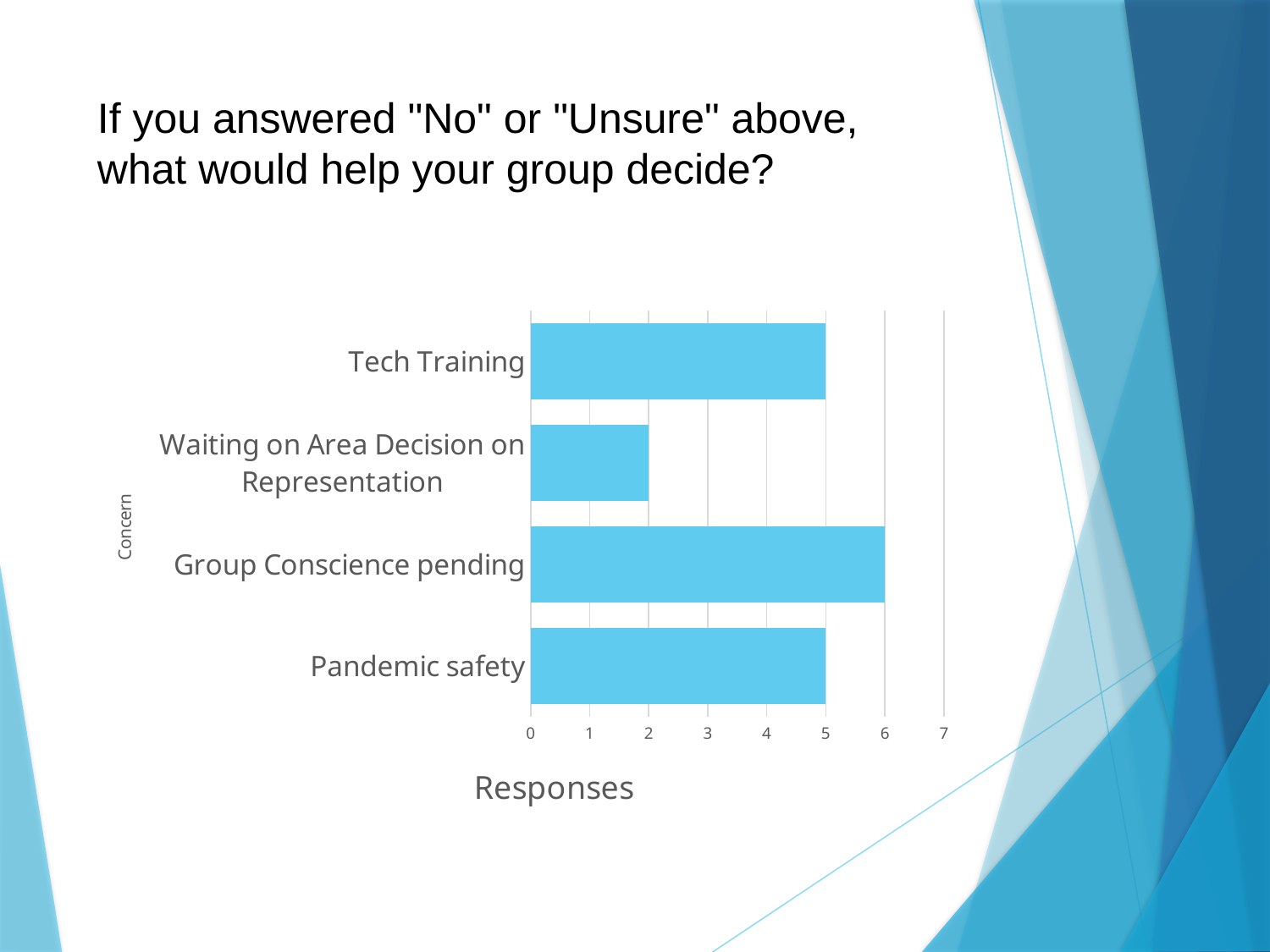
How many concern categories are shown in the chart? 4 What is the label of the horizontal axis of the chart? Responses Which concern has the lowest number of responses? Waiting on Area Decision on Representation Which has more responses, Tech Training or Waiting on Area Decision on Representation? Tech Training Is the value for Group Conscience pending greater or less than 4? greater How many responses are shown for Group Conscience pending? 6 How many responses are shown for Waiting on Area Decision on Representation? 2 What kind of chart is shown on the slide? Bar chart How many responses are shown for Pandemic safety? 5 What is the difference in responses between Group Conscience pending and Waiting on Area Decision on Representation? 4 Which concern has the highest number of responses? Group Conscience pending How many responses are shown for Tech Training? 5